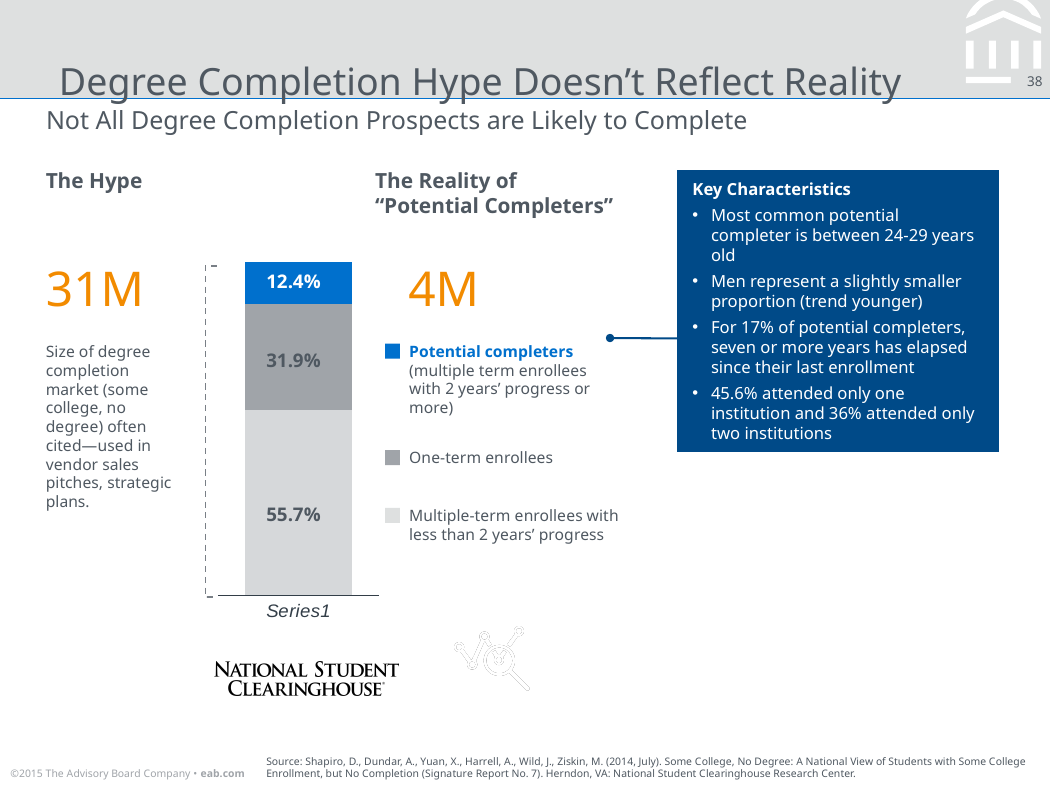
What is the difference in percentage points between the one-term enrollees segment and the potential completers segment? 19.5 Which segment of the stacked bar is the largest? Multiple-term enrollees with less than 2 years' progress Which is larger: the one-term enrollees segment or the potential completers segment? One-term enrollees What is the category label shown beneath the stacked bar? Series1 What kind of chart is shown on the slide? Stacked bar chart What percentage of the stacked bar is labelled for multiple-term enrollees with less than 2 years' progress (the light gray segment)? 55.7% What is the difference in percentage points between the multiple-term enrollees with less than 2 years' progress segment and the one-term enrollees segment? 23.8 What is the total of the three segments in the stacked bar? 100% How many segments make up the stacked bar? 3 Which segment of the stacked bar is the smallest? Potential completers What percentage of the stacked bar is labelled for one-term enrollees (the dark gray segment)? 31.9% What percentage of the stacked bar is labelled for potential completers (the blue segment)? 12.4%